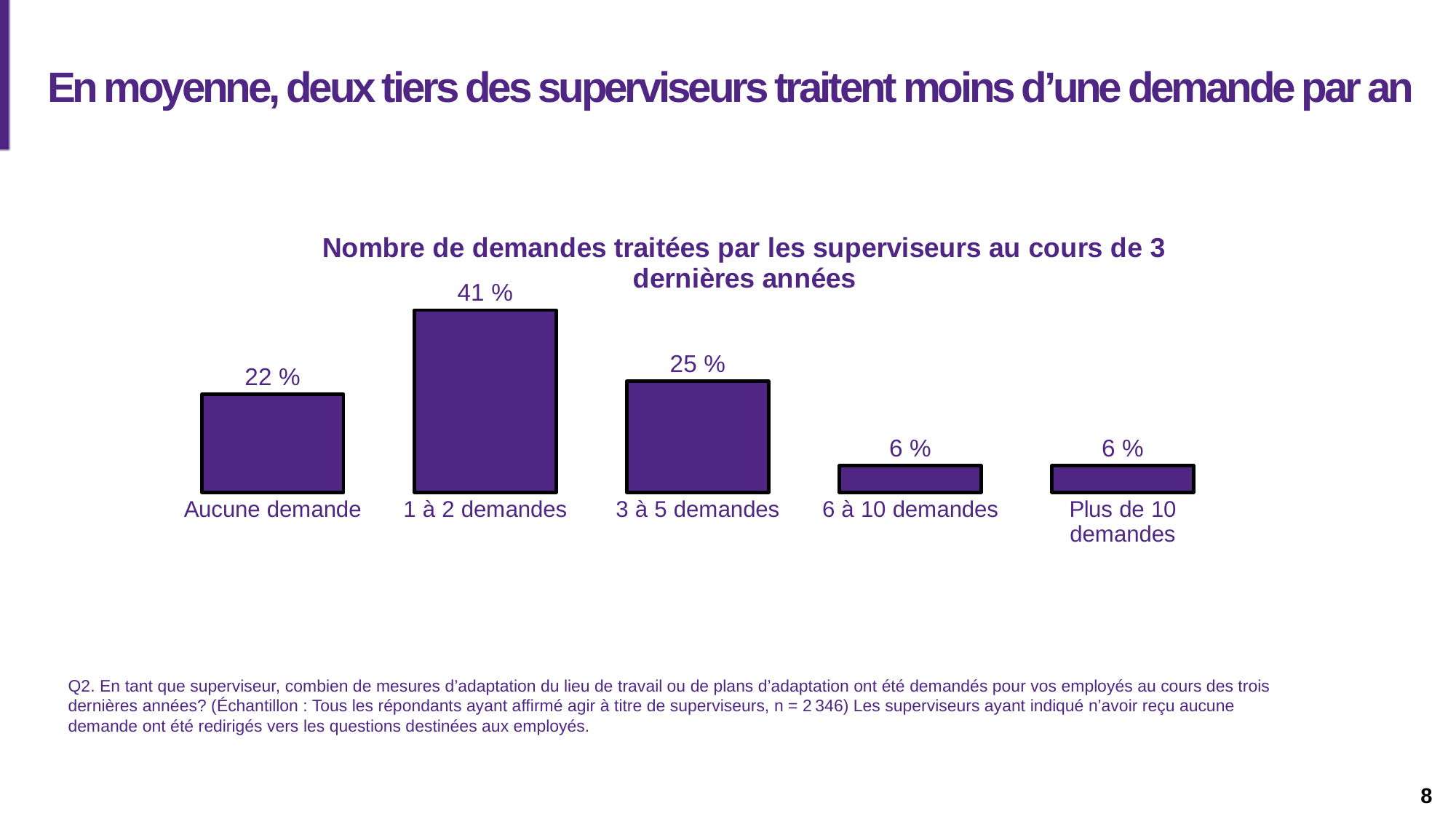
Which is larger, the value for "Aucune demande" or the value for "3 à 5 demandes"? 3 à 5 demandes Which category has the highest value? 1 à 2 demandes How many categories are shown in the chart? 5 What is the title of the chart? Nombre de demandes traitées par les superviseurs au cours de 3 dernières années What colour are the bars in the chart? Purple What is the difference between the values for "Aucune demande" and "6 à 10 demandes"? 16 % What is the difference between the values for "1 à 2 demandes" and "3 à 5 demandes"? 16 % What kind of chart is shown on the slide? Bar chart What is the value for "1 à 2 demandes"? 41 % What is the value for "Aucune demande"? 22 % What is the value for "3 à 5 demandes"? 25 % What is the value for "6 à 10 demandes"? 6 %